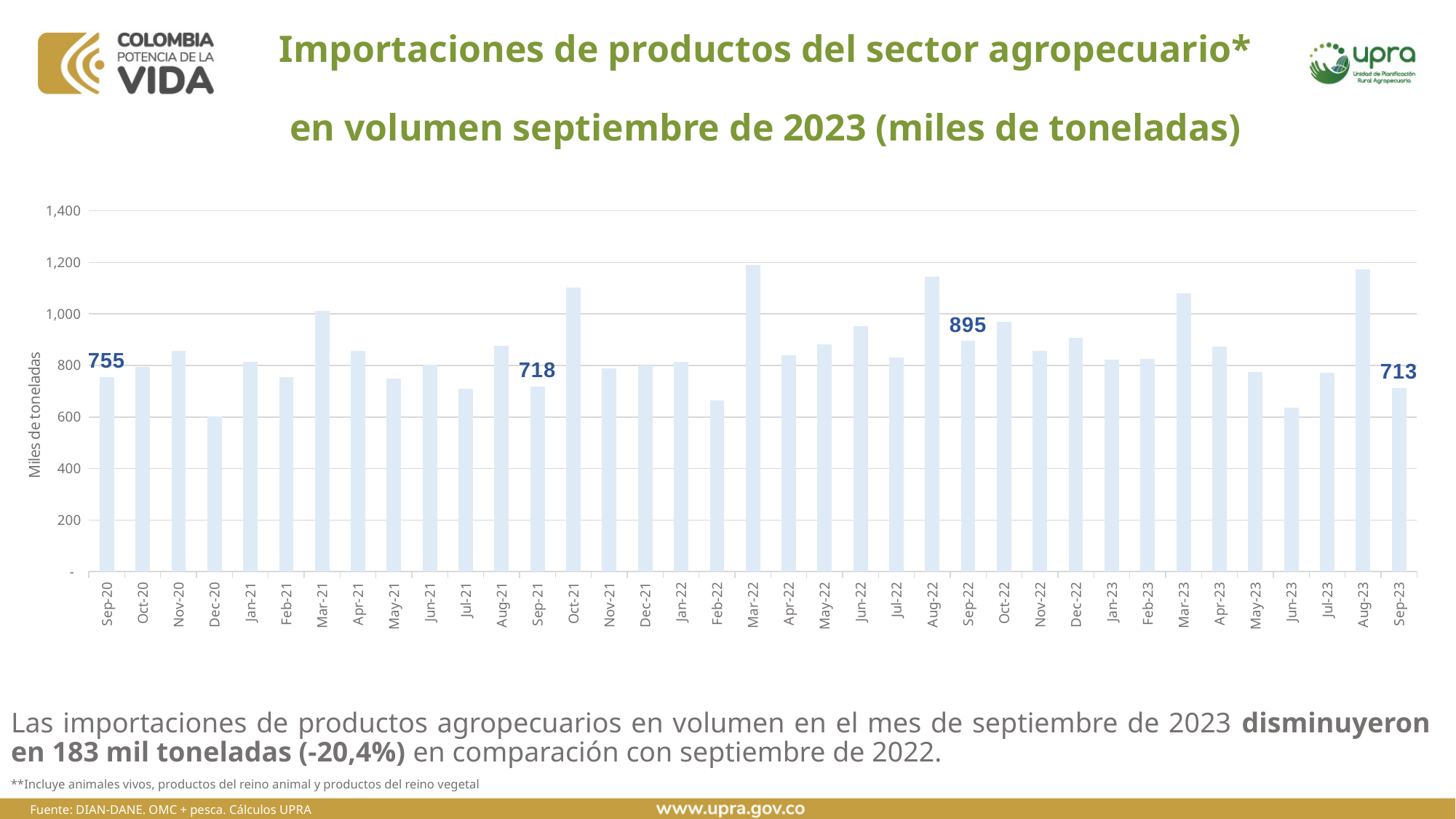
What is the difference between the values for Sep-20 and Sep-21? 37 What is the value for Sep-21? 718 What type of chart is shown on the slide? bar chart Which is larger, the value for Sep-22 or the value for Sep-21? Sep-22 What is the difference between the values for Sep-22 and Sep-20? 140 What is the value for Sep-22? 895 What is the label of the vertical axis? Miles de toneladas How many monthly bars are plotted in the chart? 37 What is the value for Sep-23? 713 Is the value for Mar-22 greater or less than 1,000? greater Is the value for Dec-20 greater or less than 800? less What is the value for Sep-20? 755